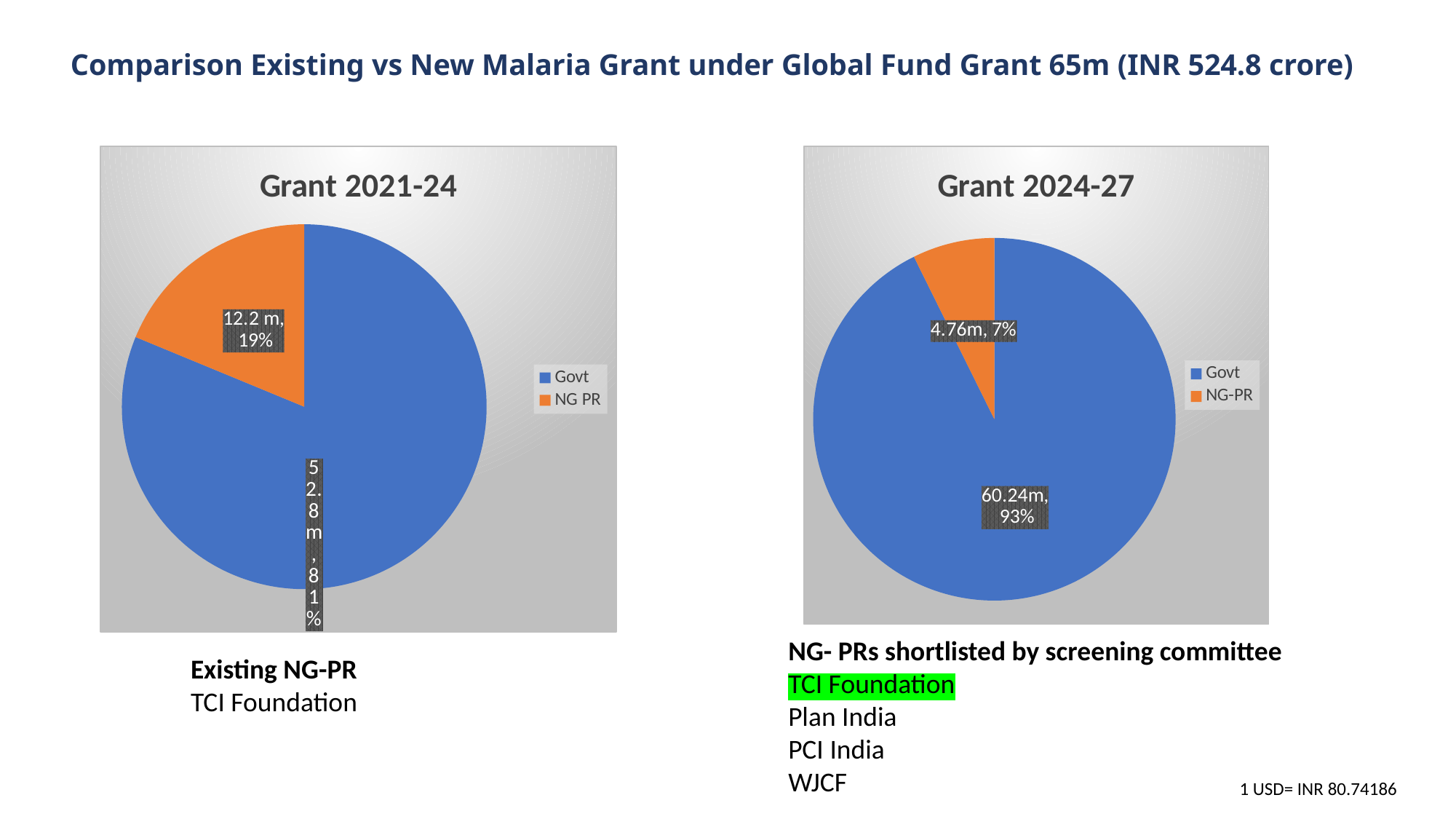
What colour represents Govt in the Grant 2021-24 chart? Blue In the Grant 2021-24 chart, what percentage share does Govt have? 81% In the Grant 2021-24 chart, what is the value shown for NG PR? 12.2 m, 19% How many slices does the Grant 2021-24 pie chart have? 2 In the Grant 2021-24 chart, which slice is the smallest? NG PR In the Grant 2021-24 chart, which is larger, Govt or NG PR? Govt How many entries does the legend of the Grant 2024-27 chart list? 2 In the Grant 2024-27 chart, which slice is the largest? Govt In the Grant 2024-27 chart, what percentage share does NG-PR have? 7% In the Grant 2024-27 chart, what is the difference in percentage points between the Govt share and the NG-PR share? 86 percentage points What type of chart is the Grant 2024-27 chart? Pie chart In the Grant 2024-27 chart, what is the value shown for Govt? 60.24m, 93%